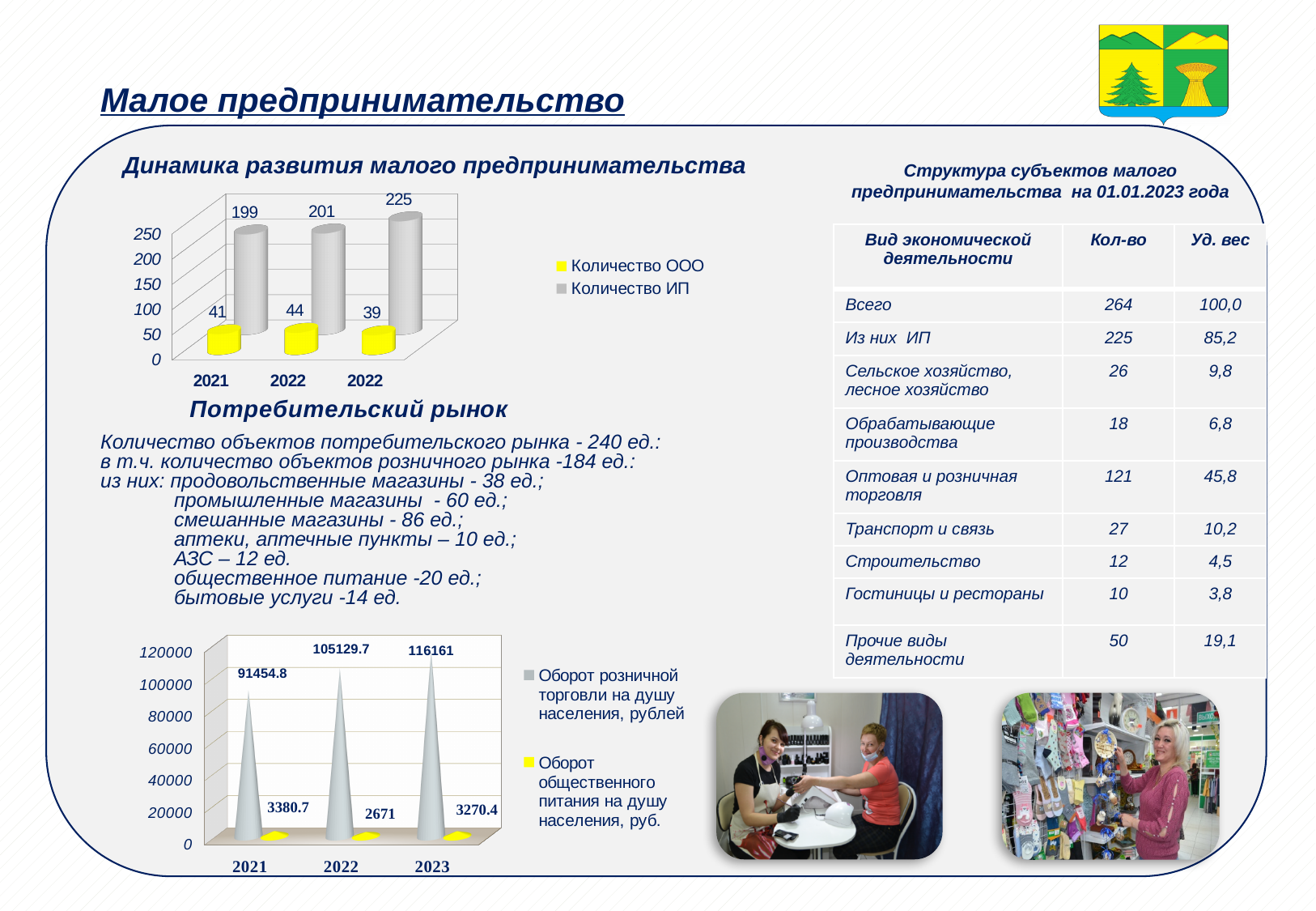
In the chart titled 'Динамика развития малого предпринимательства', what is the value of Количество ИП for 2021? 199 In the bottom-left chart, what is the value of Оборот розничной торговли на душу населения for 2023? 116161 In the bottom-left chart, does Оборот розничной торговли на душу населения rise or fall from 2021 to 2023? Rises In the chart titled 'Динамика развития малого предпринимательства', which colour represents Количество ООО? Yellow In the chart titled 'Динамика развития малого предпринимательства', what is the difference between the rightmost Количество ИП value (225) and the 2021 value (199)? 26 In the bottom-left chart, which year has the lowest value for Оборот общественного питания на душу населения? 2022 In the chart titled 'Динамика развития малого предпринимательства', what is the lowest value shown for Количество ООО? 39 In the chart titled 'Динамика развития малого предпринимательства', how many series does the legend list? 2 In the bottom-left chart, what is the value of Оборот общественного питания на душу населения for 2022? 2671 In the chart titled 'Динамика развития малого предпринимательства', what is the highest value shown for Количество ИП? 225 In the chart titled 'Динамика развития малого предпринимательства', what is the value of Количество ООО for 2021? 41 In the bottom-left chart, how many years are shown on the x axis? 3